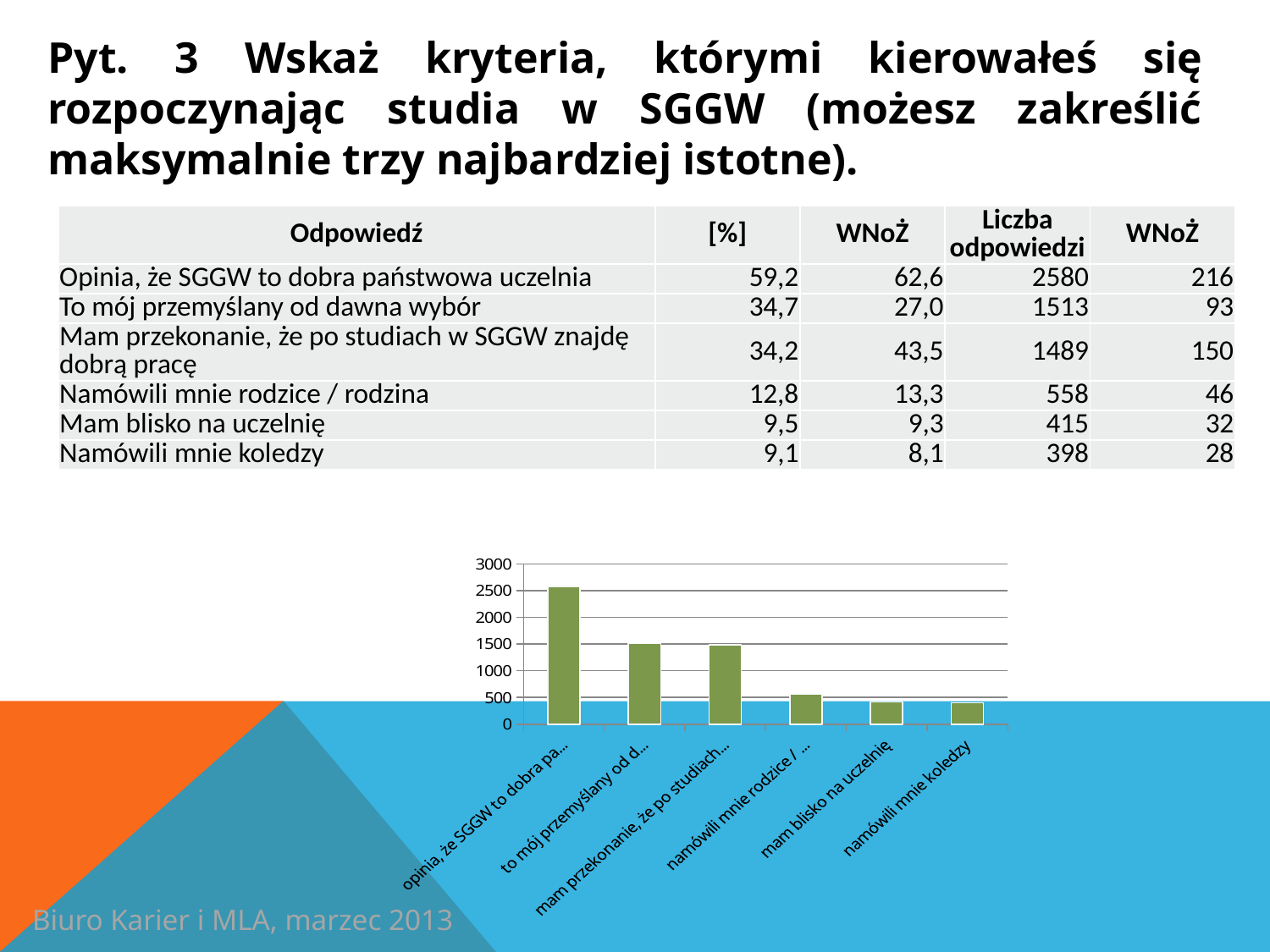
Is the value for 'namówili mnie koledzy' greater or less than 500? less How many bars does the chart show? 6 Is the value for 'mam blisko na uczelnię' greater or less than 500? less Is the value of the first bar (opinia, że SGGW to dobra pa...) greater or less than 2500? greater Which is larger: the bar for 'opinia, że SGGW to dobra pa...' or the bar for 'to mój przemyślany od d...'? opinia, że SGGW to dobra pa... Do the bar values rise or fall from left to right along the x axis? fall What kind of chart is shown on the slide? bar chart What is the highest value shown on the chart's vertical axis? 3000 Which category has the highest bar in the chart? opinia, że SGGW to dobra pa... Which is larger: the bar for 'namówili mnie rodzice / ...' or the bar for 'mam blisko na uczelnię'? namówili mnie rodzice / ...